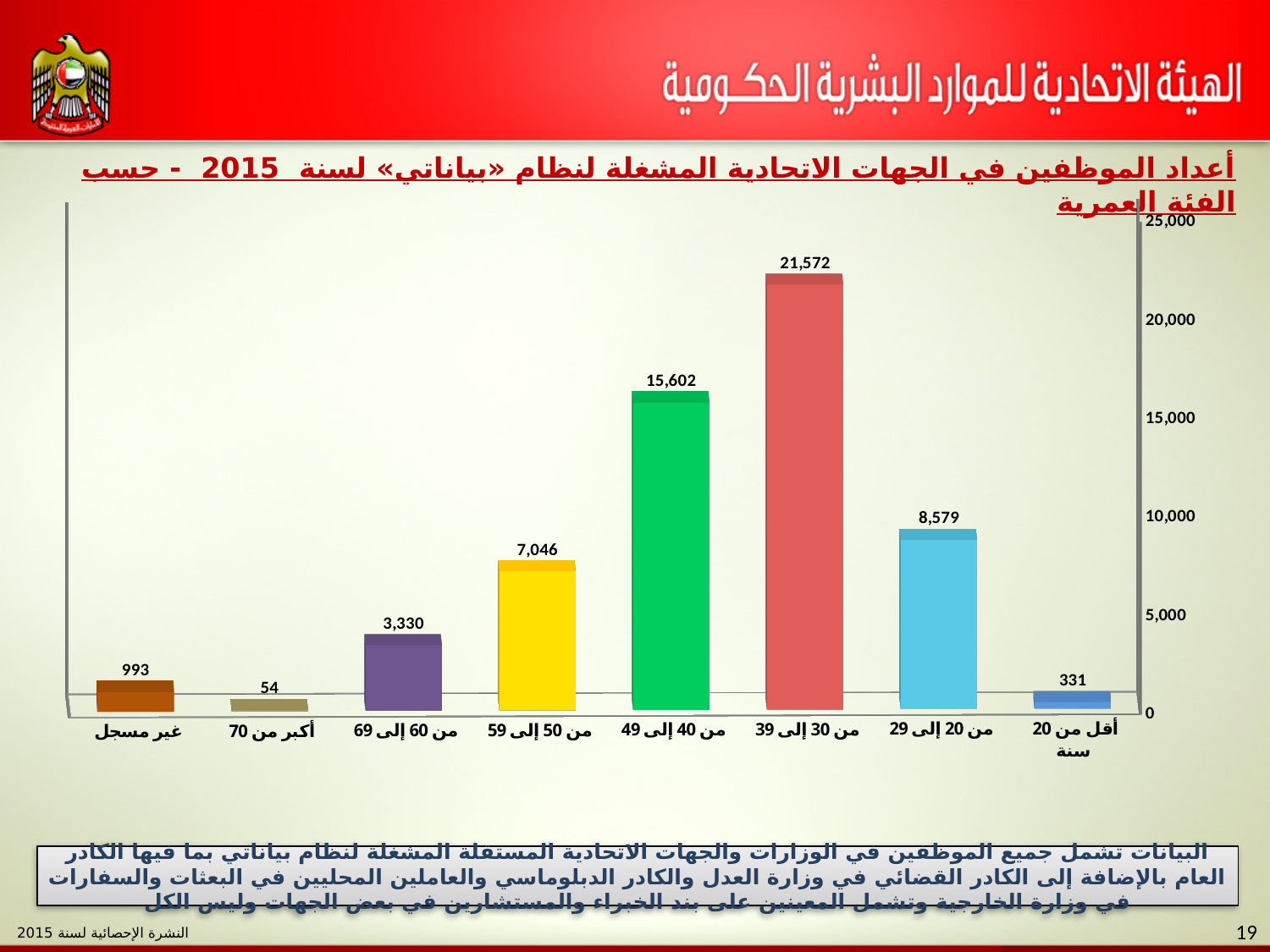
What is the maximum value shown on the vertical axis? 25,000 Which age group has the highest number of employees? من 30 إلى 39 Is the value for من 40 إلى 49 greater or less than 15,000? greater What is the value for the age group من 30 إلى 39 (30 to 39)? 21,572 How many age categories are shown on the chart? 8 What kind of chart is shown on the slide? bar chart What is the difference between the values for من 30 إلى 39 and من 40 إلى 49? 5,970 What is the difference between the values for أقل من 20 سنة and أكبر من 70? 277 What is the value for the category غير مسجل (not registered)? 993 Which is larger: the value for من 50 إلى 59 or the value for من 60 إلى 69? من 50 إلى 59 What is the value for the age group من 20 إلى 29 (20 to 29)? 8,579 Which category has the lowest value? أكبر من 70